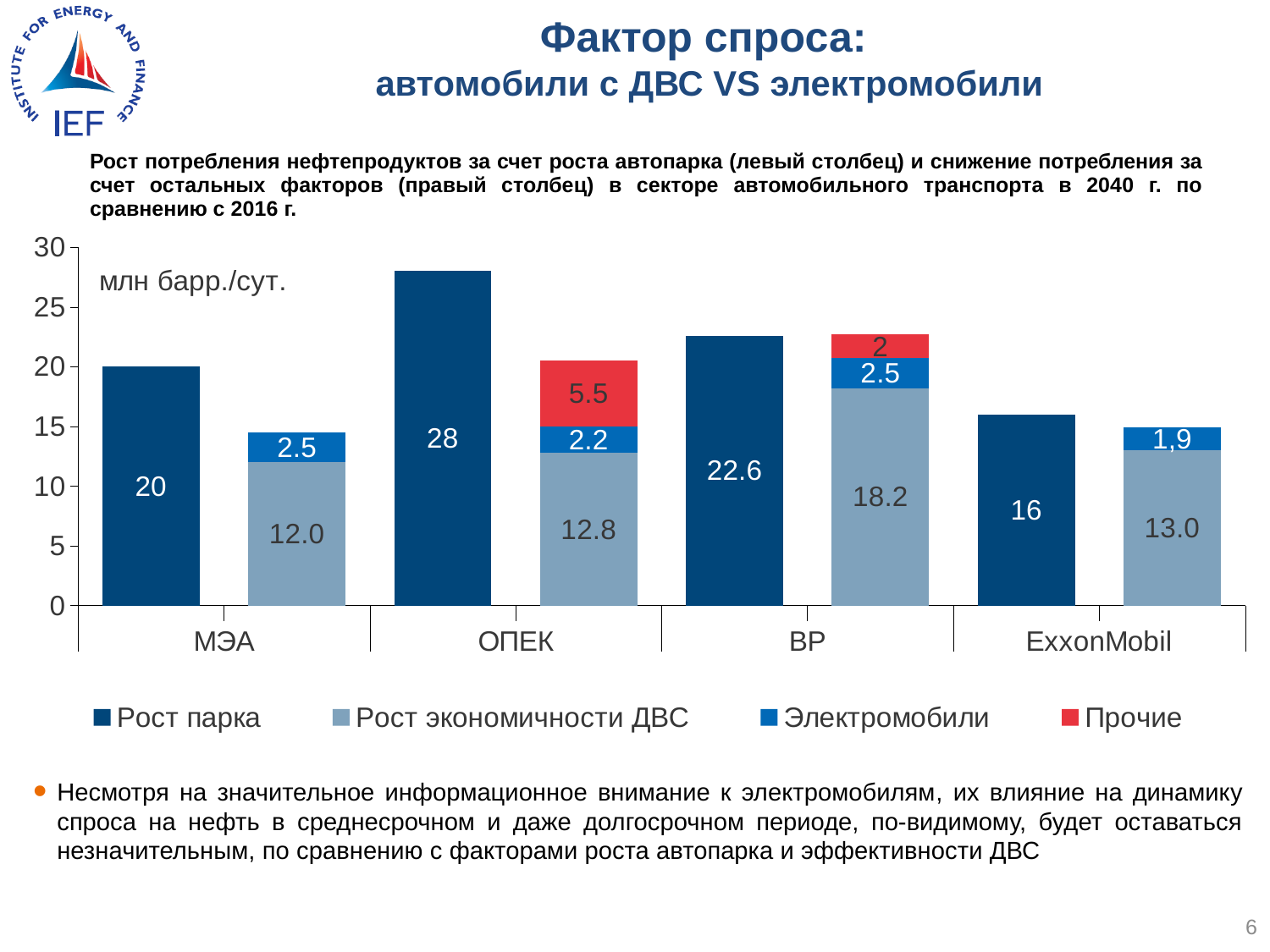
How many categories are shown on the x axis? 4 What is the value of Рост экономичности ДВС for BP? 18.2 What is the value of Электромобили for ExxonMobil? 1,9 What is the value of Рост парка for ОПЕК? 28 Which category has the lowest value for Рост парка? ExxonMobil What kind of chart is shown on the slide? Stacked bar chart What is the total of the stacked bar (Рост экономичности ДВС, Электромобили, Прочие) for ОПЕК? 20.5 Which is larger: Рост экономичности ДВС for BP or for ОПЕК? BP What is the value of Прочие for ОПЕК? 5.5 What is the difference between the Рост парка values for ОПЕК and МЭА? 8 Which category has the highest value for Рост парка? ОПЕК How many series does the legend list? 4